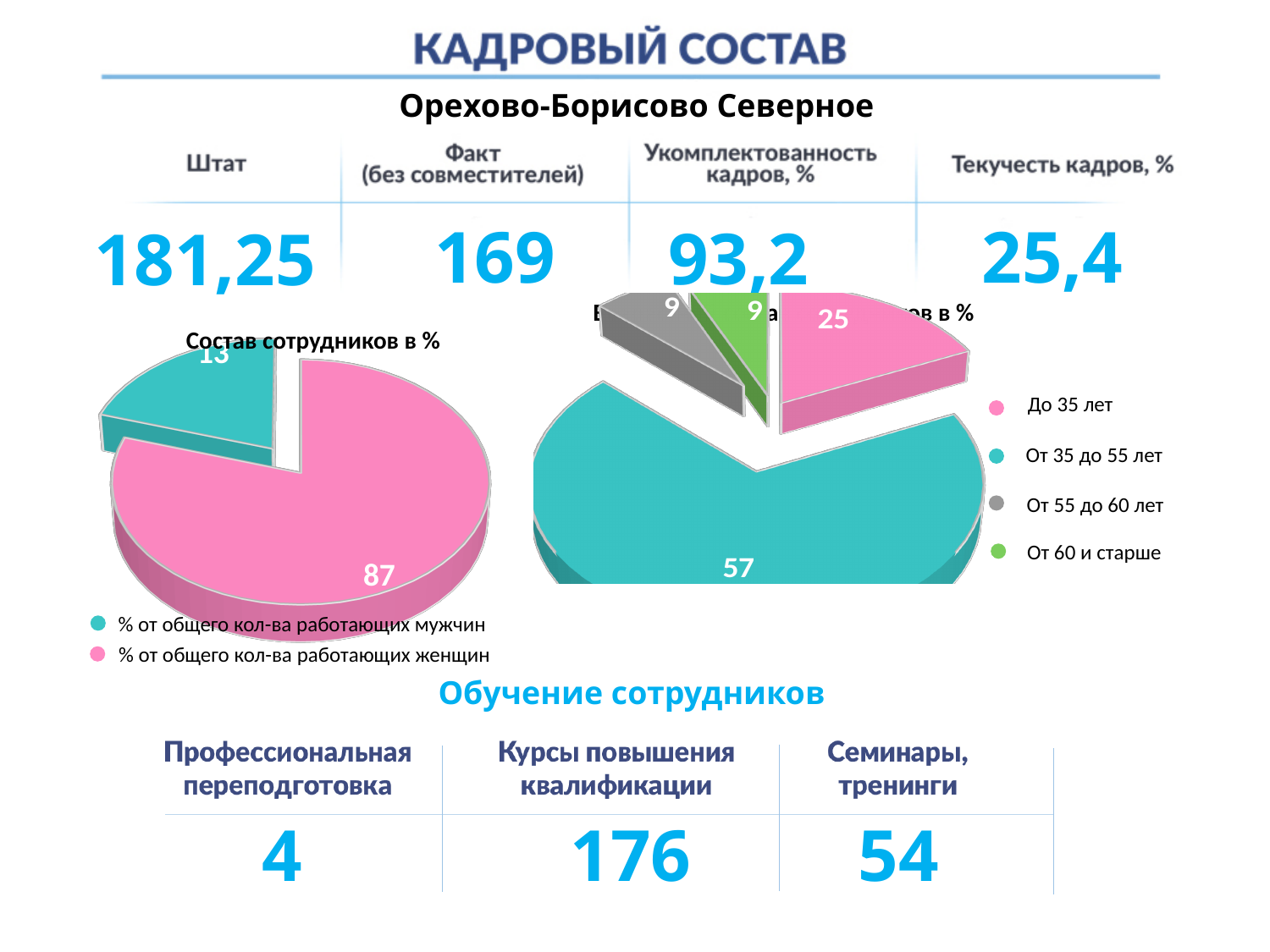
In the left pie chart 'Состав сотрудников в %', what is the value for '% от общего кол-ва работающих женщин'? 87 In the left pie chart 'Состав сотрудников в %', which category has the larger share? % от общего кол-ва работающих женщин In the right pie chart (age distribution), what is the value for 'До 35 лет'? 25 In the right pie chart (age distribution), what is the value for 'От 35 до 55 лет'? 57 In the right pie chart (age distribution), how many categories does the legend list? 4 In the left pie chart 'Состав сотрудников в %', what is the difference between the women's and men's values? 74 In the right pie chart (age distribution), what is the value for 'От 55 до 60 лет'? 9 In the left pie chart 'Состав сотрудников в %', what is the value for '% от общего кол-ва работающих мужчин'? 13 In the right pie chart (age distribution), which category has the largest share? От 35 до 55 лет What type of chart is the left chart 'Состав сотрудников в %'? Pie chart In the left pie chart 'Состав сотрудников в %', how many slices are there? 2 In the right pie chart (age distribution), what is the difference between the values for 'От 35 до 55 лет' and 'До 35 лет'? 32